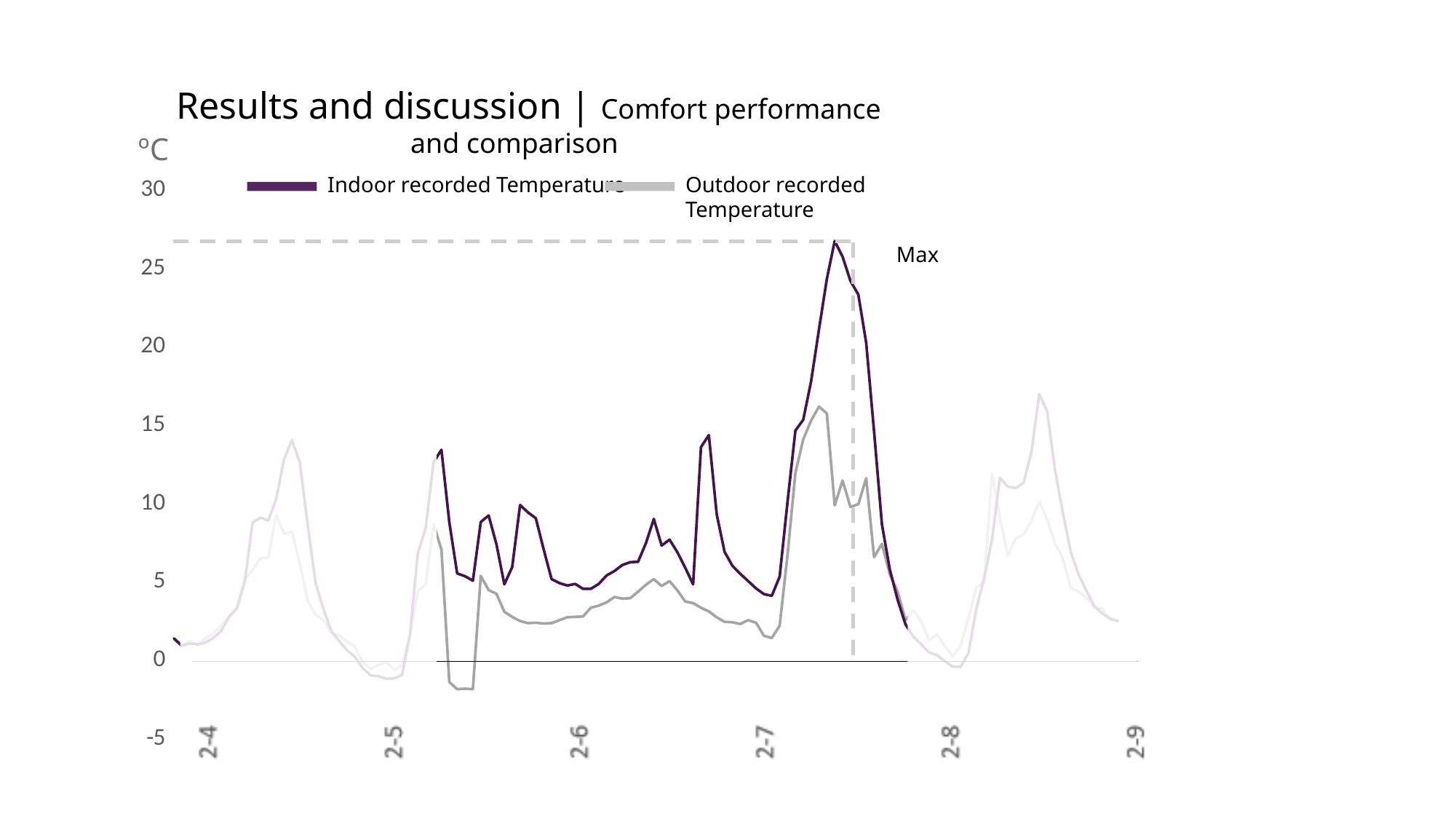
What are the two series named in the legend? Indoor recorded Temperature and Outdoor recorded Temperature How many series does the legend list? 2 Is the lowest value of the Outdoor recorded Temperature just after 2-5 greater or less than 0? less At the peak between 2-7 and 2-8, which series has the higher value, Indoor recorded Temperature or Outdoor recorded Temperature? Indoor recorded Temperature What is the lowest value shown on the y axis? -5 Is the peak value of the Outdoor recorded Temperature between 2-7 and 2-8 greater or less than 10? greater What kind of chart is shown on the slide? line chart What unit is shown at the top of the y axis? ºC Is the peak value of the Indoor recorded Temperature greater or less than 25? greater How many date labels are shown along the x axis? 6 Which series reaches the highest value on the chart, marked 'Max'? Indoor recorded Temperature Does the Indoor recorded Temperature rise or fall between its peak marked 'Max' and the 2-8 label? fall